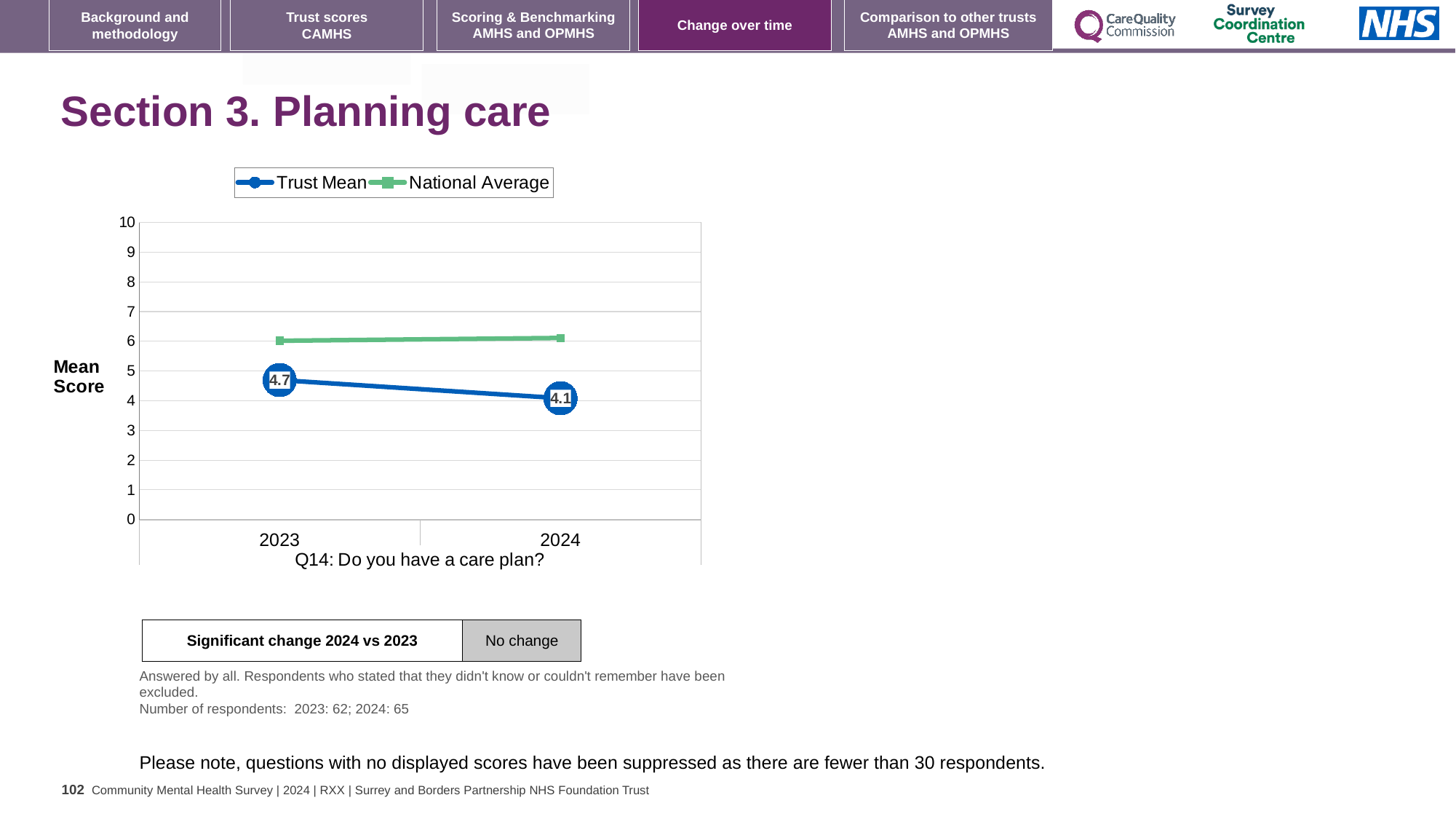
Which year has the higher Trust Mean, 2023 or 2024? 2023 What is the Trust Mean value for 2023? 4.7 How many series does the chart legend list? 2 In 2024, which is higher, the Trust Mean or the National Average? National Average Is the National Average value for 2023 greater or less than 5? greater Is the National Average value for 2024 greater or less than 7? less By how much did the Trust Mean change from 2023 to 2024? 0.6 How many years are shown on the x axis of the chart? 2 What is the Trust Mean value for 2024? 4.1 Does the Trust Mean rise or fall from 2023 to 2024? fall What kind of chart is shown on the slide? line chart Which survey question does the chart relate to? Q14: Do you have a care plan?